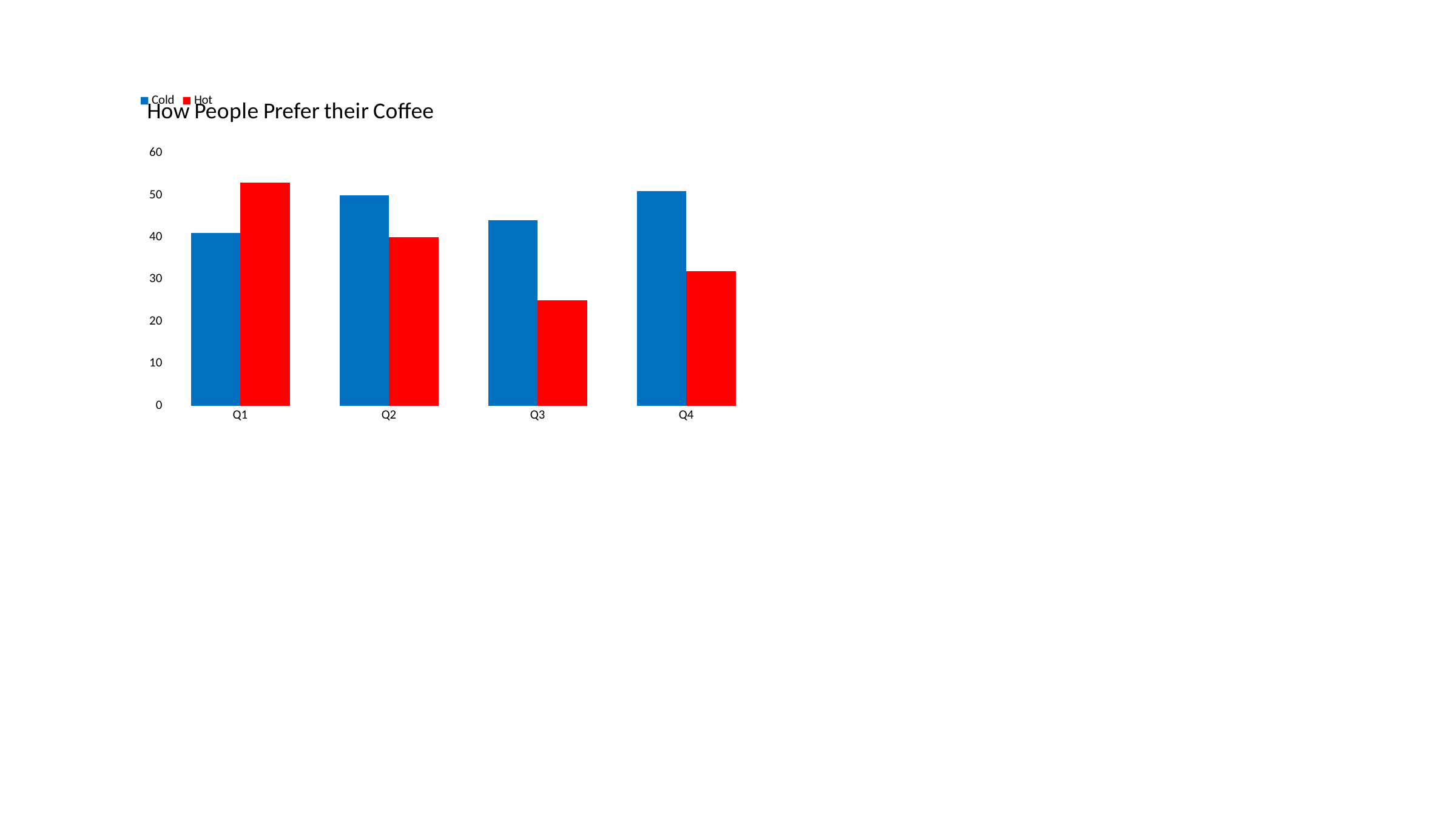
What is the title of the chart? How People Prefer their Coffee In Q3, which is larger, Cold or Hot? Cold In which quarter is the Hot value highest? Q1 In Q1, which is larger, Cold or Hot? Hot How many series does the legend list? 2 Is the Hot value for Q3 greater or less than 30? less Is the Hot value for Q1 greater or less than 50? greater What kind of chart is shown on the slide? bar chart In which quarter is the Hot value lowest? Q3 How many categories are shown on the x axis? 4 Which series is shown in red? Hot Does the Hot value rise or fall from Q1 to Q3? fall